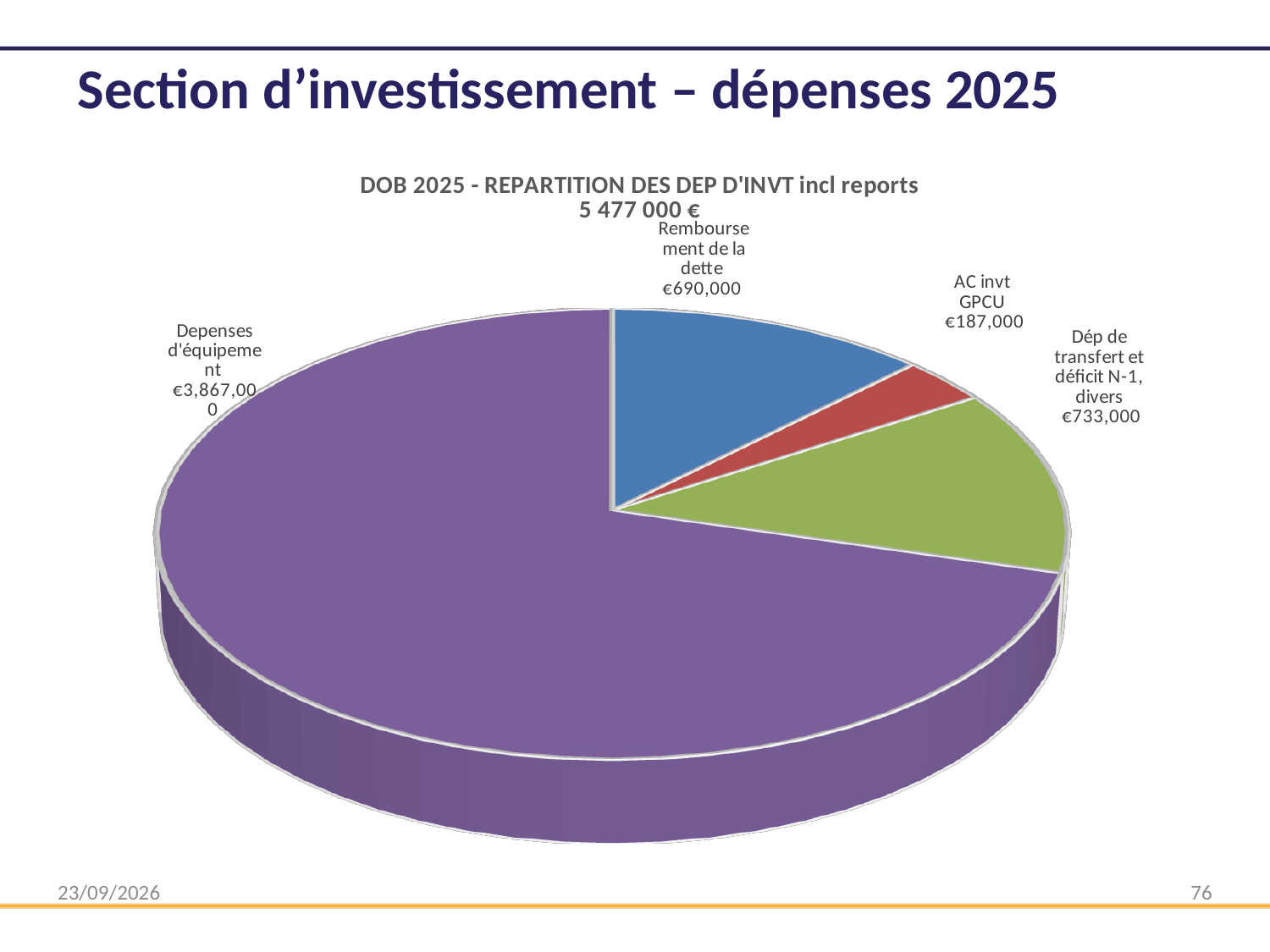
What is the value of the Dép de transfert et déficit N-1, divers slice? €733,000 Which category has the largest slice of the pie? Depenses d'équipement How many slices does the pie chart have? 4 What total amount is shown in the chart title? 5 477 000 € What is the value of the AC invt GPCU slice? €187,000 What kind of chart is shown on the slide? Pie chart What is the value of the Remboursement de la dette slice? €690,000 What colour is the Depenses d'équipement slice? Purple What is the value of the Depenses d'équipement slice? €3,867,000 What is the difference between the Dép de transfert et déficit N-1, divers slice and the Remboursement de la dette slice? €43,000 Which category has the smallest slice of the pie? AC invt GPCU Which is larger, Remboursement de la dette or AC invt GPCU? Remboursement de la dette